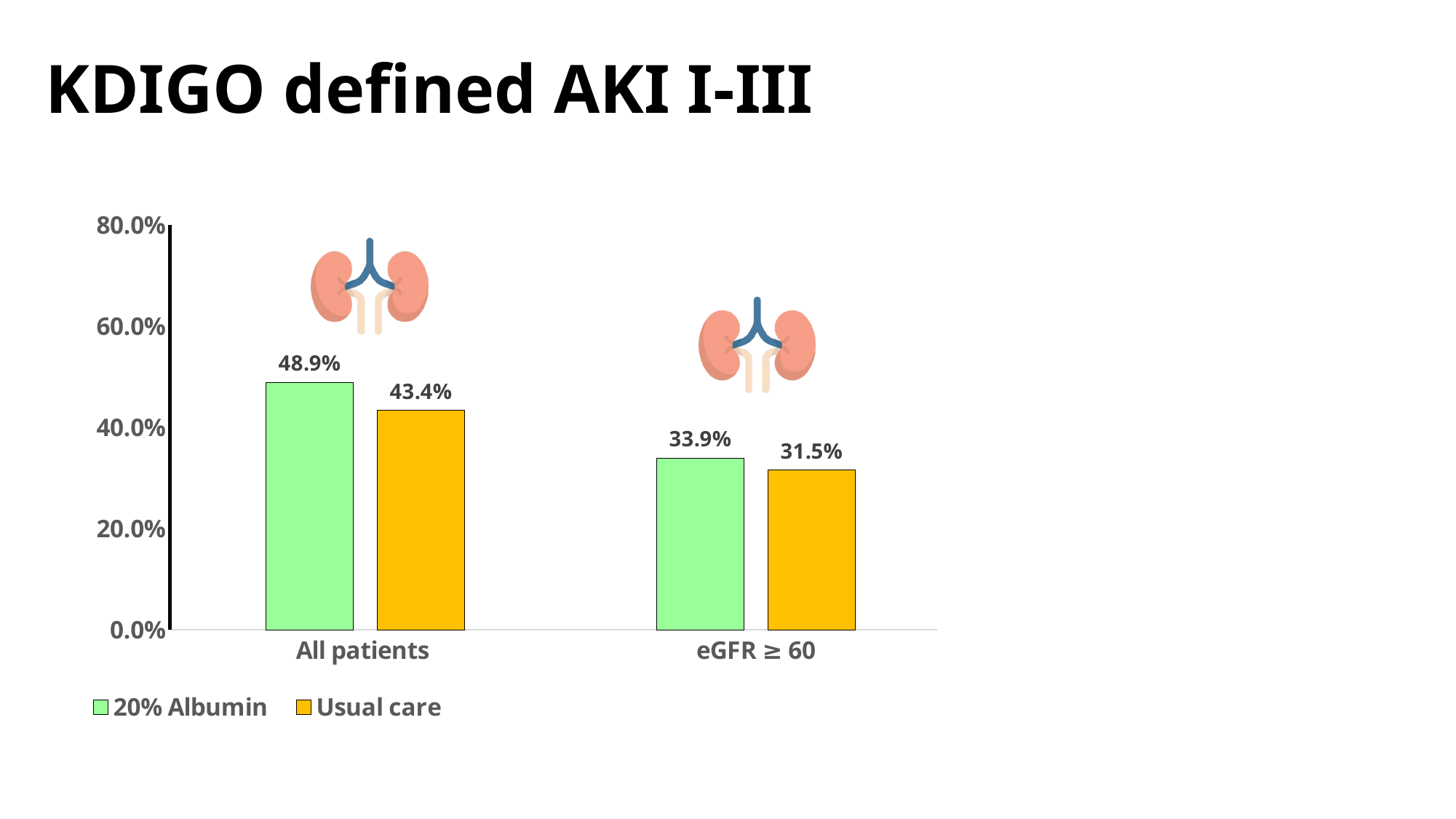
How many categories are shown on the x axis? 2 How many series does the legend list? 2 In the eGFR ≥ 60 group, which is larger: 20% Albumin or Usual care? 20% Albumin Which bar has the highest value on the chart? 20% Albumin, All patients What is the value for Usual care in the eGFR ≥ 60 group? 31.5% What kind of chart is shown on the slide? Bar chart What is the difference between 20% Albumin and Usual care in the All patients group? 5.5% What is the value for Usual care in the All patients group? 43.4% What is the value for 20% Albumin in the All patients group? 48.9% Which bar has the lowest value on the chart? Usual care, eGFR ≥ 60 What is the difference between 20% Albumin and Usual care in the eGFR ≥ 60 group? 2.4% What is the value for 20% Albumin in the eGFR ≥ 60 group? 33.9%